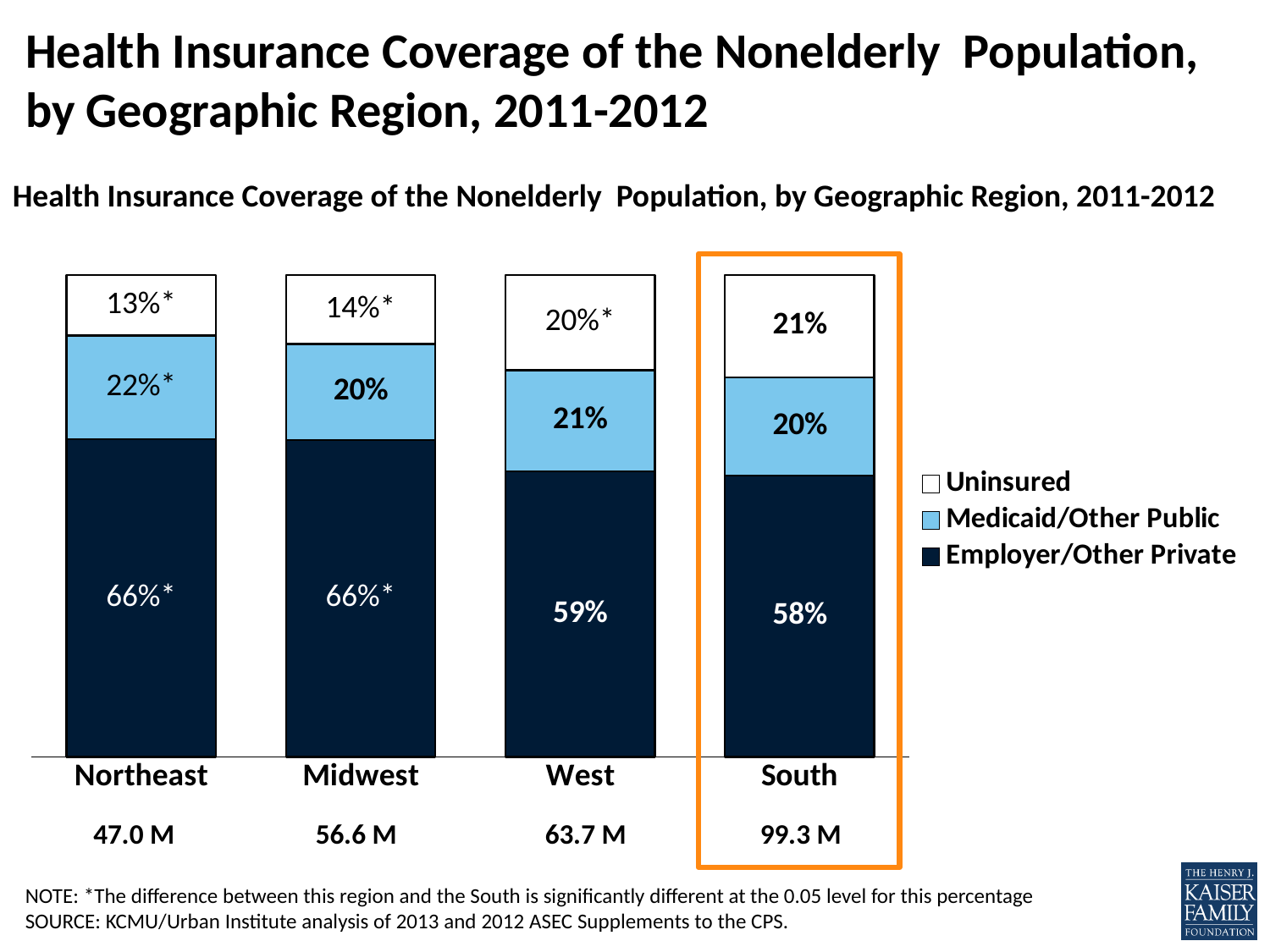
What is the nonelderly population figure shown beneath the South bar? 99.3 M What type of chart is shown on the slide? Stacked bar chart What is the Medicaid/Other Public percentage for the Midwest? 20% What is the Employer/Other Private percentage for the Northeast? 66% Which region has the lowest Employer/Other Private percentage? South Which is larger, the Employer/Other Private share in the Midwest or in the West? Midwest How many series does the legend list? 3 Which region has the lowest Uninsured percentage? Northeast How many regions are shown in the chart? 4 What is the Employer/Other Private share for the West? 59% What is the difference in the Uninsured percentage between the South and the Northeast? 8 percentage points What percentage of the nonelderly population in the South is Uninsured? 21%